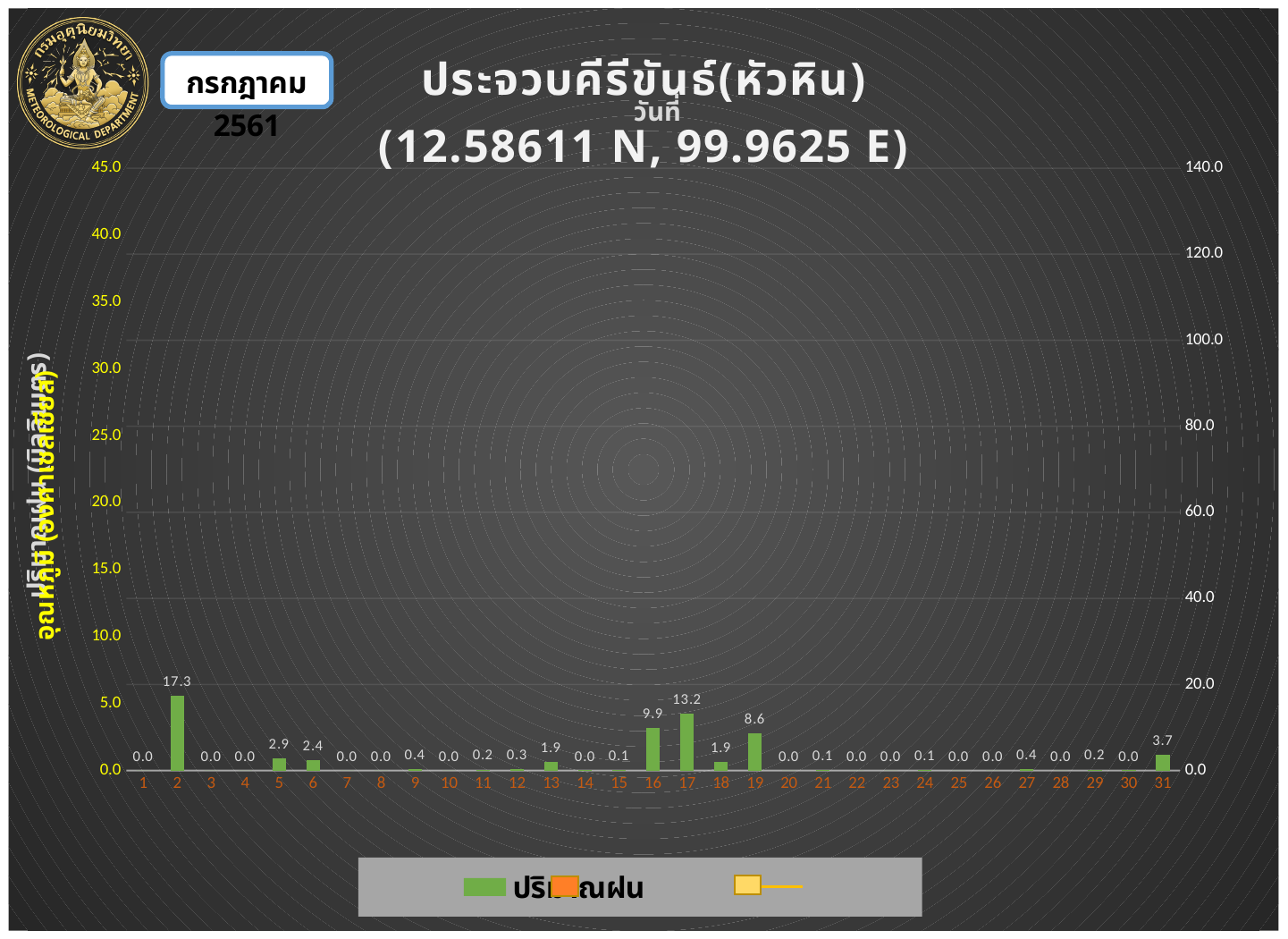
What is the difference between the rainfall values for day 16 and day 19? 1.3 Which is larger, the rainfall value for day 16 or for day 17? day 17 Which is larger, the rainfall value for day 5 or for day 6? day 5 How many days are shown on the x axis of the chart? 31 What coordinates are given in the chart title? 12.58611 N, 99.9625 E What is the rainfall value shown for day 17? 13.2 What kind of chart is used to show the rainfall values? bar chart What is the rainfall value shown for day 2? 17.3 What is the rainfall value shown for day 19? 8.6 Which day has the highest rainfall value? 2 What is the rainfall value shown for day 31? 3.7 What is the difference between the rainfall values for day 2 and day 17? 4.1